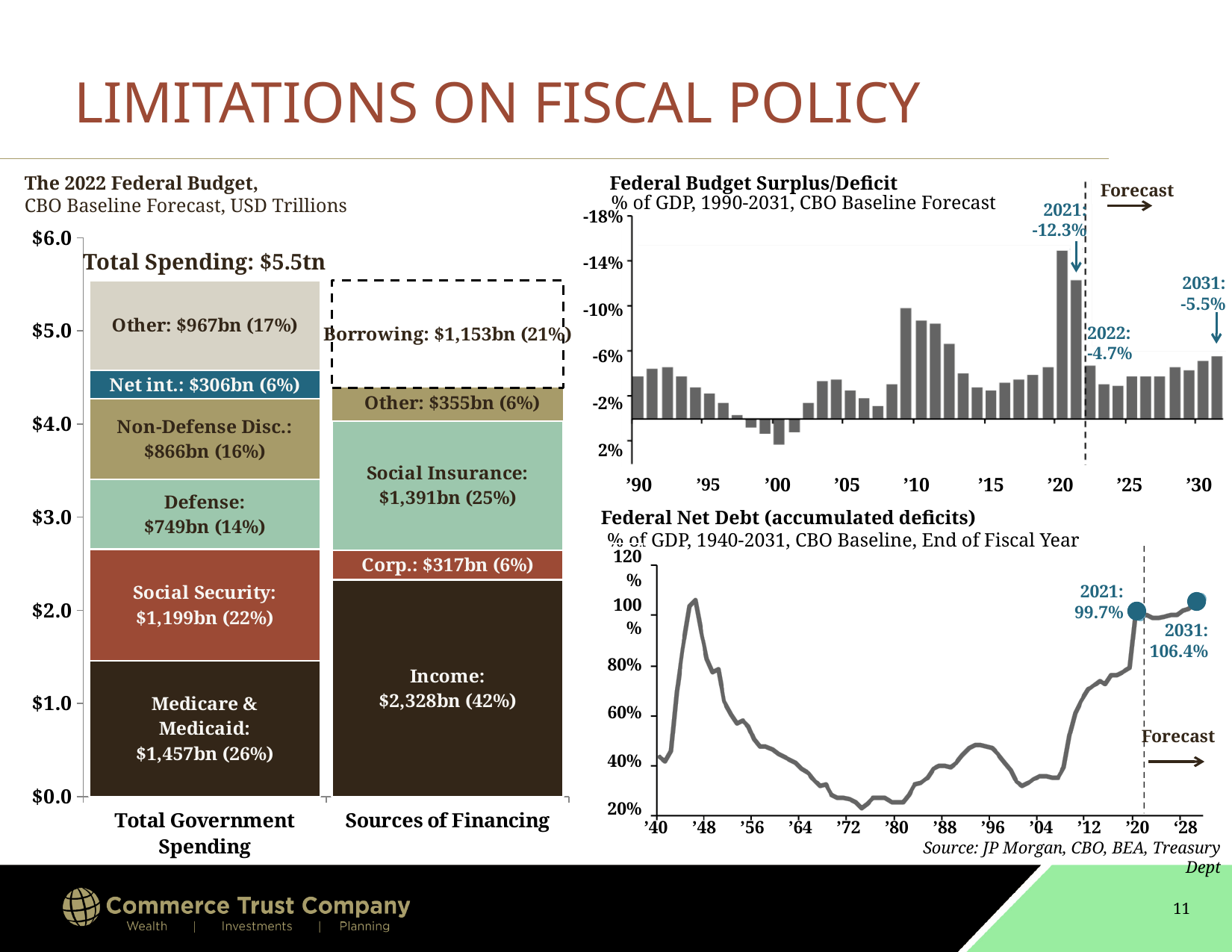
In the 2022 Federal Budget chart, what is the value shown for Medicare & Medicaid in the Total Government Spending bar? $1,457bn (26%) In the 2022 Federal Budget chart, what is the value shown for Borrowing in the Sources of Financing bar? $1,153bn (21%) In the 2022 Federal Budget chart, which segment of the Total Government Spending bar is the smallest? Net int. In the 2022 Federal Budget chart, what is the total spending figure printed above the bars? $5.5tn In the 2022 Federal Budget chart, what is the difference between Social Security and Defense spending? $450bn What kind of chart is the Federal Net Debt chart? Line chart In the Federal Net Debt chart, what is the labeled value for 2021? 99.7% In the Federal Budget Surplus/Deficit chart, what is the forecast value labeled for 2031? -5.5% In the Federal Budget Surplus/Deficit chart, what is the labeled value for 2021? -12.3% In the 2022 Federal Budget chart, which is larger in the Sources of Financing bar: Income or Social Insurance? Income In the 2022 Federal Budget chart, how many segments make up the Sources of Financing bar? 5 In the 2022 Federal Budget chart, which segment of the Total Government Spending bar is the largest? Medicare & Medicaid